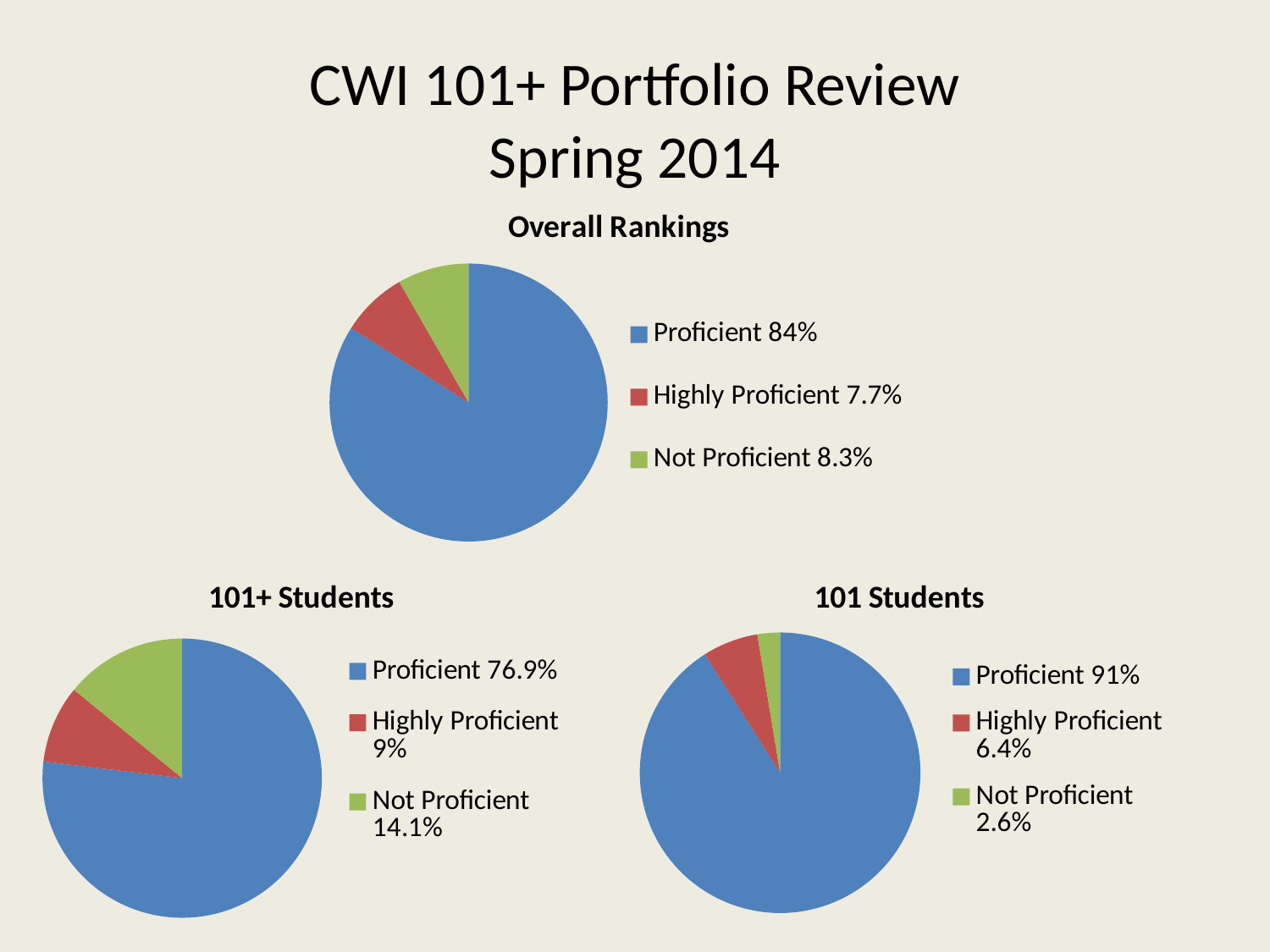
In the Overall Rankings chart, which category has the largest slice? Proficient How many slices does the Overall Rankings chart have? 3 In the 101+ Students chart, which category has the smallest slice? Highly Proficient In the 101 Students chart, which category has the smallest slice? Not Proficient In the Overall Rankings chart, what share is Proficient? 84% In the 101 Students chart, what is the difference between the Highly Proficient and Not Proficient shares? 3.8% In the 101+ Students chart, what share is Not Proficient? 14.1% In the 101 Students chart, what share is Proficient? 91% Which chart has the larger Proficient share, 101+ Students or 101 Students? 101 Students What kind of chart is the 101+ Students chart? Pie chart